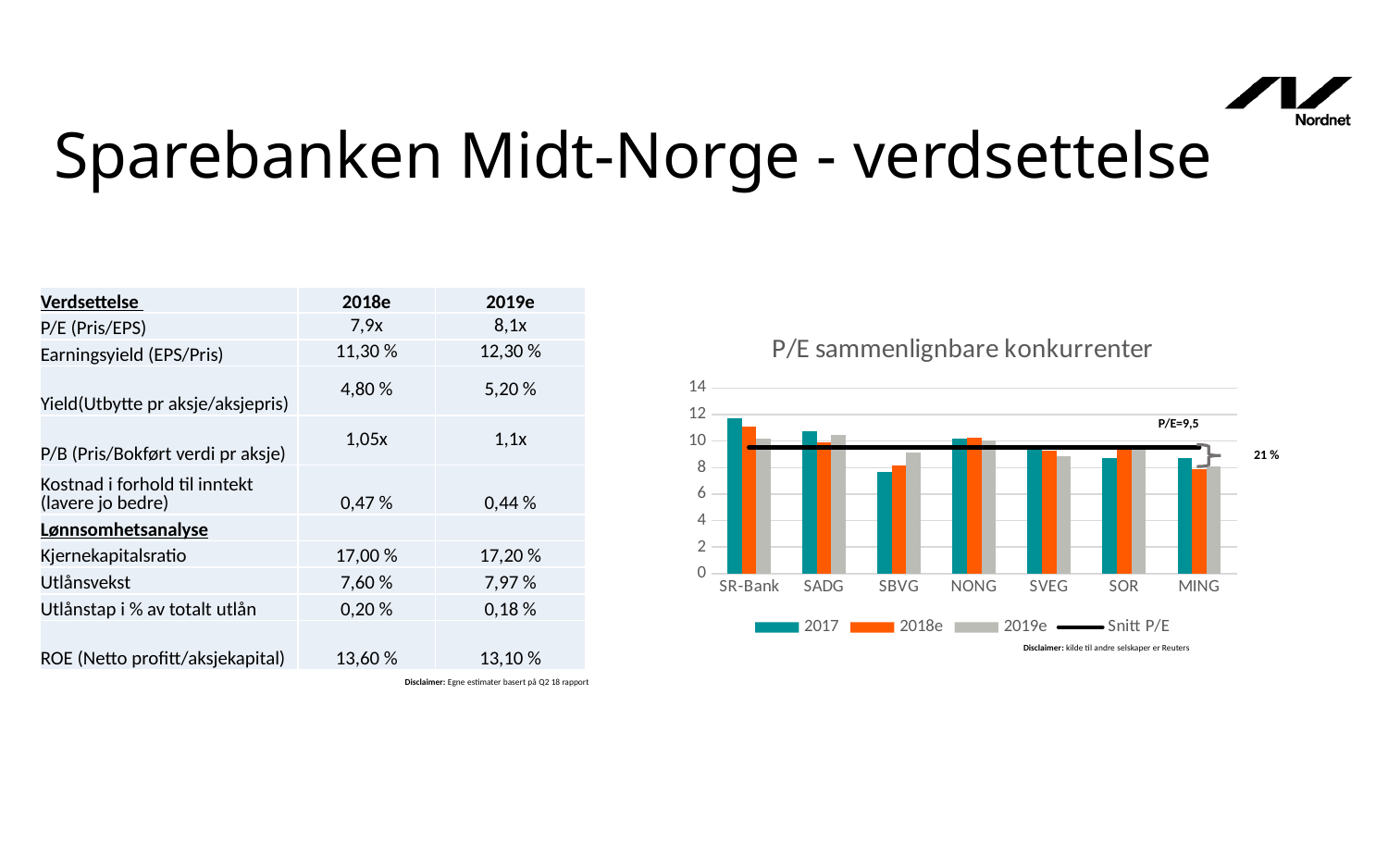
Is the 2017 value for SR-Bank greater or less than 10? greater What kind of chart is shown on the slide? combination bar and line chart What average P/E value is labelled on the horizontal line in the chart? P/E=9,5 Which bank has the highest 2017 P/E in the chart? SR-Bank How many banks (categories) are shown on the x axis of the P/E chart? 7 Which is larger, the 2017 P/E for SR-Bank or the 2017 P/E for MING? SR-Bank For SBVG, which is larger, the 2017 value or the 2019e value? 2019e Is the 2017 value for NONG greater or less than 8? greater How many entries does the legend of the P/E chart list? 4 What is the title of the chart on the slide? P/E sammenlignbare konkurrenter Which bank has the lowest 2017 P/E in the chart? SBVG Is the 2019e value for SVEG greater or less than 10? less